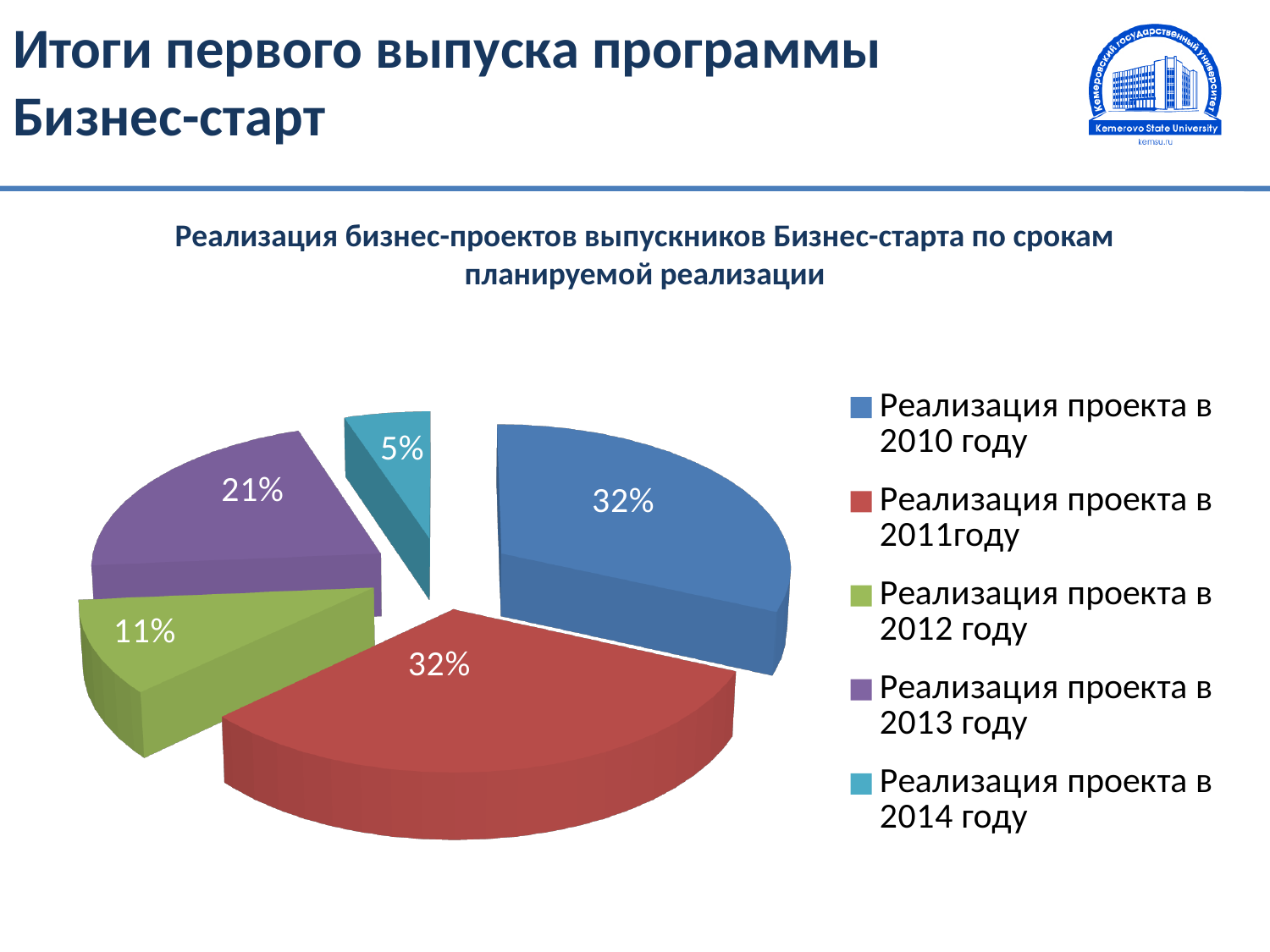
Which is larger: the share for 2013 or the share for 2012? 2013 How many slices does the pie chart have? 5 What share of projects is planned for implementation in 2013 (Реализация проекта в 2013 году)? 21% What share of projects is planned for implementation in 2012 (Реализация проекта в 2012 году)? 11% What share of projects is planned for implementation in 2014 (Реализация проекта в 2014 году)? 5% What kind of chart is shown on the slide? pie chart What share of projects is planned for implementation in 2010 (Реализация проекта в 2010 году)? 32% What colour is the slice for Реализация проекта в 2011году? red How many entries does the legend list? 5 What is the difference between the share for 2011 and the share for 2014? 27% What is the difference between the share for 2013 and the share for 2012? 10% Which year has the smallest share of planned project implementation? Реализация проекта в 2014 году